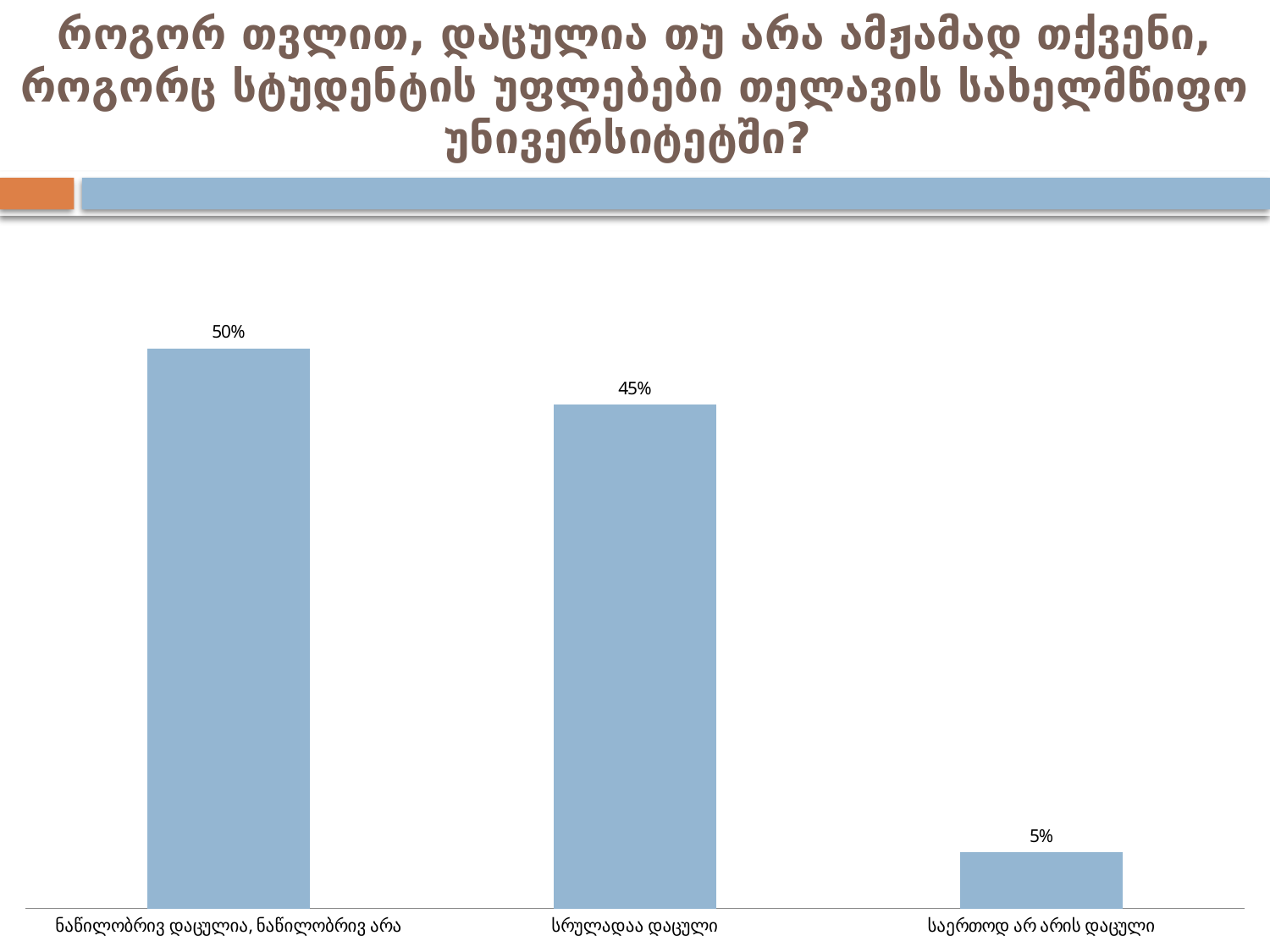
Do the values rise or fall from left to right across the categories? Fall What is the value for "საერთოდ არ არის დაცული"? 5% How many categories are shown in the chart? 3 What kind of chart is shown on the slide? Bar chart What is the difference between the values for "ნაწილობრივ დაცულია, ნაწილობრივ არა" and "სრულადაა დაცული"? 5% What is the value for "ნაწილობრივ დაცულია, ნაწილობრივ არა"? 50% What is the value for "სრულადაა დაცული"? 45% Which is larger: the value for "სრულადაა დაცული" or the value for "საერთოდ არ არის დაცული"? სრულადაა დაცული What is the difference between the values for "სრულადაა დაცული" and "საერთოდ არ არის დაცული"? 40% What colour are the bars in the chart? Light blue Which category has the lowest value? საერთოდ არ არის დაცული Which category has the highest value? ნაწილობრივ დაცულია, ნაწილობრივ არა